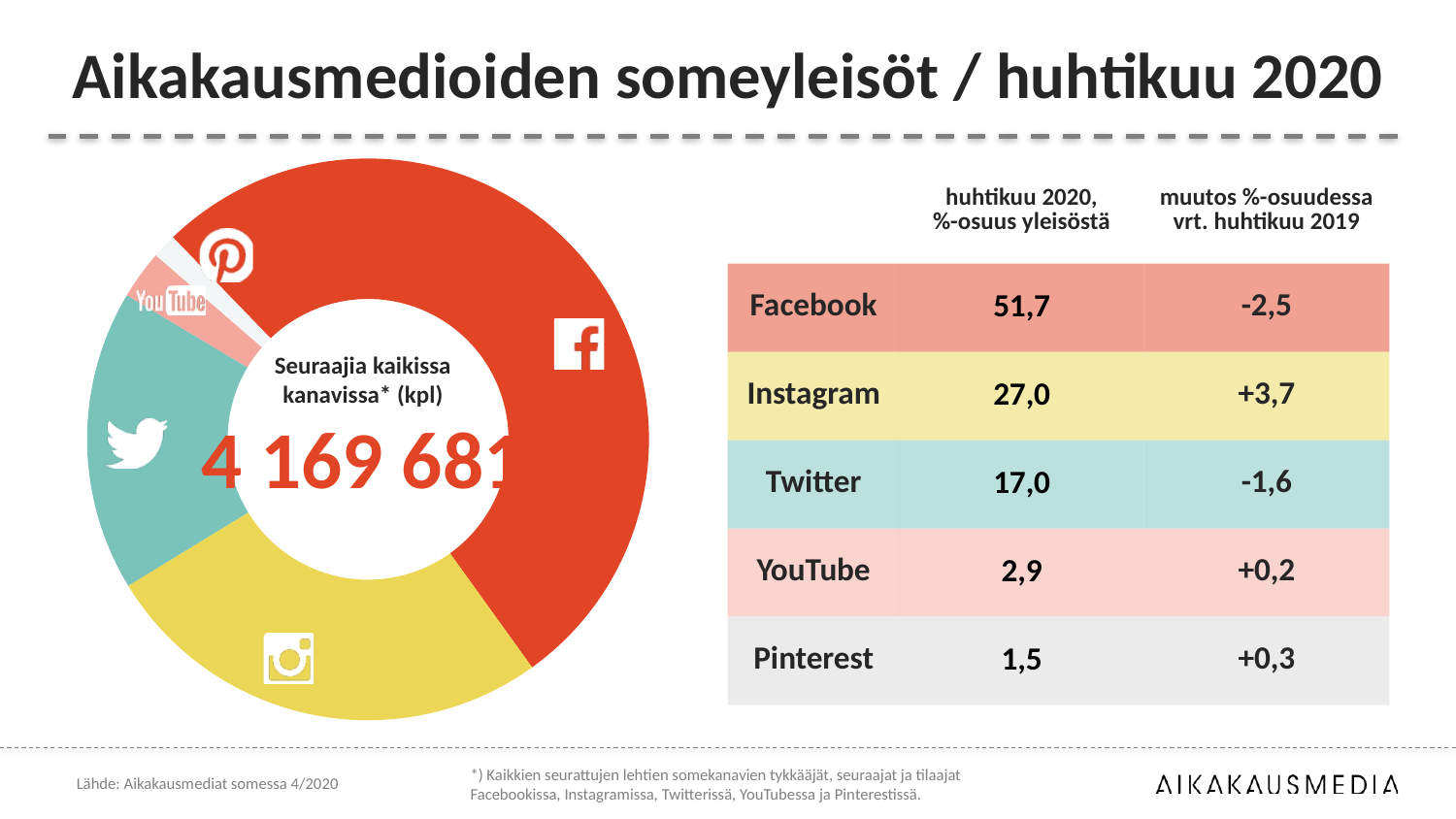
According to the table, what is Facebook's share of the audience in April 2020 (huhtikuu 2020, %-osuus yleisöstä)? 51,7 According to the table, what is the change in percentage share for Instagram compared with April 2019? +3,7 According to the table, what is Instagram's share of the audience in April 2020? 27,0 What kind of chart is shown on the left of the slide? Pie chart (donut) Which channel has the smallest share of the audience in April 2020? Pinterest Which has a larger share of the audience in April 2020, Twitter or YouTube? Twitter How many social media channels are shown as slices in the donut chart? 5 According to the table, what is the change in percentage share for Facebook compared with April 2019? -2,5 What is the title of the slide? Aikakausmedioiden someyleisöt / huhtikuu 2020 Which channel has the largest share of the audience in April 2020? Facebook What is the difference between Facebook's and Instagram's share of the audience in April 2020? 24,7 Which channel had the largest increase in percentage share compared with April 2019? Instagram